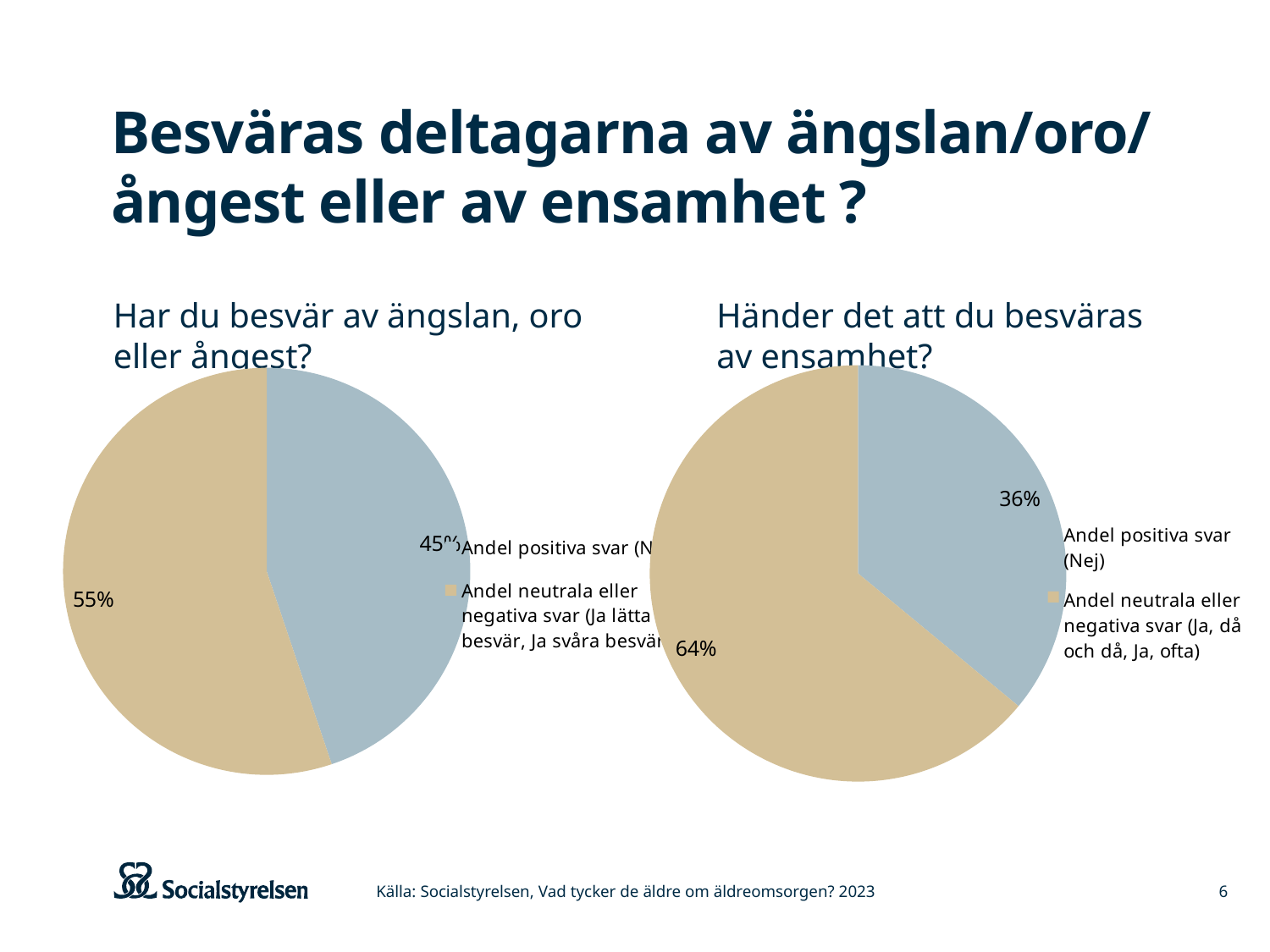
In the chart titled "Har du besvär av ängslan, oro eller ångest?", which slice is the smallest? Andel positiva svar In the chart titled "Har du besvär av ängslan, oro eller ångest?", what is the value of the "Andel positiva svar" slice? 45% In the chart titled "Händer det att du besväras av ensamhet?", what is the value of the "Andel positiva svar (Nej)" slice? 36% In the chart titled "Har du besvär av ängslan, oro eller ångest?", what is the difference between the two slices? 10% How many slices does the chart titled "Händer det att du besväras av ensamhet?" have? 2 In the chart titled "Händer det att du besväras av ensamhet?", what is the difference between the two slices? 28% Which chart has the larger "Andel positiva svar" slice, the left chart or the right chart? The left chart In the chart titled "Händer det att du besväras av ensamhet?", which slice is the largest? Andel neutrala eller negativa svar (Ja, då och då, Ja, ofta) In the chart titled "Händer det att du besväras av ensamhet?", what is the value of the "Andel neutrala eller negativa svar (Ja, då och då, Ja, ofta)" slice? 64% In the chart titled "Har du besvär av ängslan, oro eller ångest?", what share of the pie is labelled 55%? Andel neutrala eller negativa svar What kind of chart is used on the right side of the slide? Pie chart How many entries does the legend of the chart titled "Händer det att du besväras av ensamhet?" list? 2